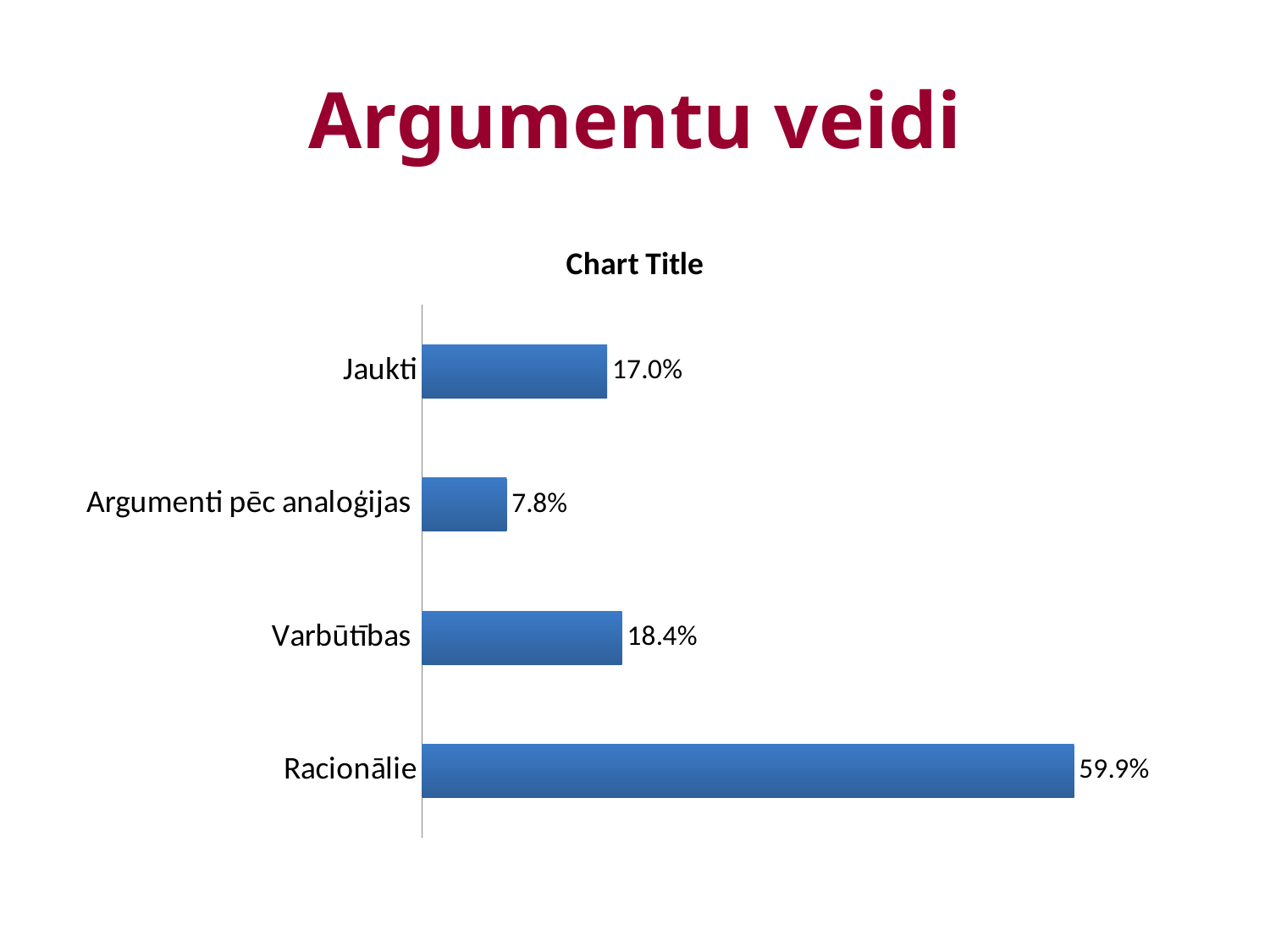
What is the value for Racionālie? 59.9% Which is larger, the value for Varbūtības or the value for Jaukti? Varbūtības What is the difference between the values for Racionālie and Varbūtības? 41.5% What is the title shown above the chart? Chart Title What is the value for Jaukti? 17.0% Which category has the lowest value? Argumenti pēc analoģijas What kind of chart is shown on the slide? Bar chart What is the difference between the values for Jaukti and Argumenti pēc analoģijas? 9.2% What is the value for Varbūtības? 18.4% How many categories are shown in the chart? 4 Which category has the highest value? Racionālie What is the value for Argumenti pēc analoģijas? 7.8%